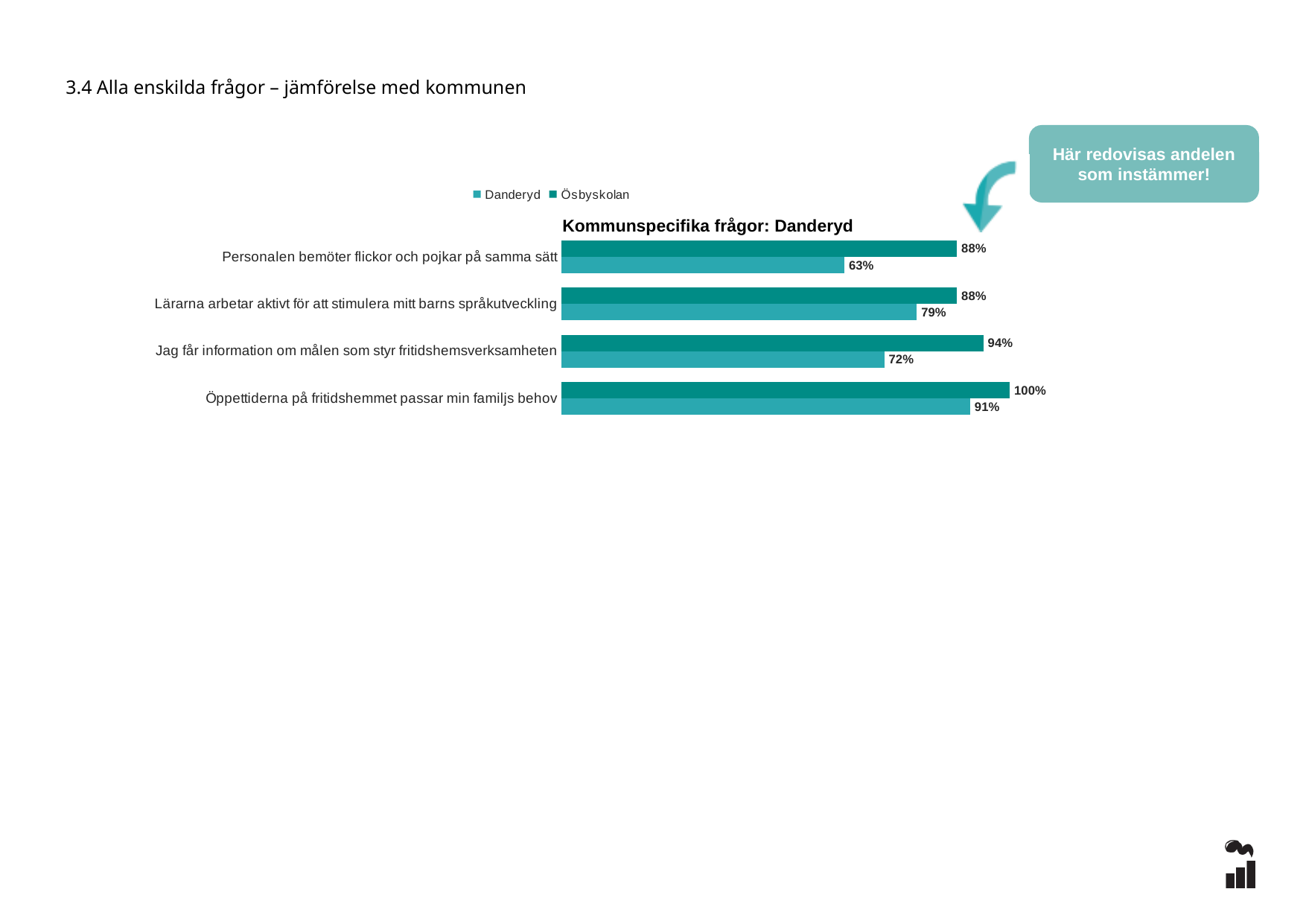
Which category has the highest Ösbyskolan value? Öppettiderna på fritidshemmet passar min familjs behov What is the Danderyd value for "Personalen bemöter flickor och pojkar på samma sätt"? 63% What kind of chart is shown on the slide? Bar chart What is the Ösbyskolan value for "Lärarna arbetar aktivt för att stimulera mitt barns språkutveckling"? 88% What is the Danderyd value for "Jag får information om målen som styr fritidshemsverksamheten"? 72% What is the Ösbyskolan value for "Öppettiderna på fritidshemmet passar min familjs behov"? 100% How many categories (questions) are shown in the chart? 4 What is the difference between the Ösbyskolan and Danderyd values for "Personalen bemöter flickor och pojkar på samma sätt"? 25 percentage points For "Jag får information om målen som styr fritidshemsverksamheten", which is larger: the Ösbyskolan value or the Danderyd value? Ösbyskolan How many series does the legend list? 2 What is the title of the chart? Kommunspecifika frågor: Danderyd Which category has the lowest Danderyd value? Personalen bemöter flickor och pojkar på samma sätt